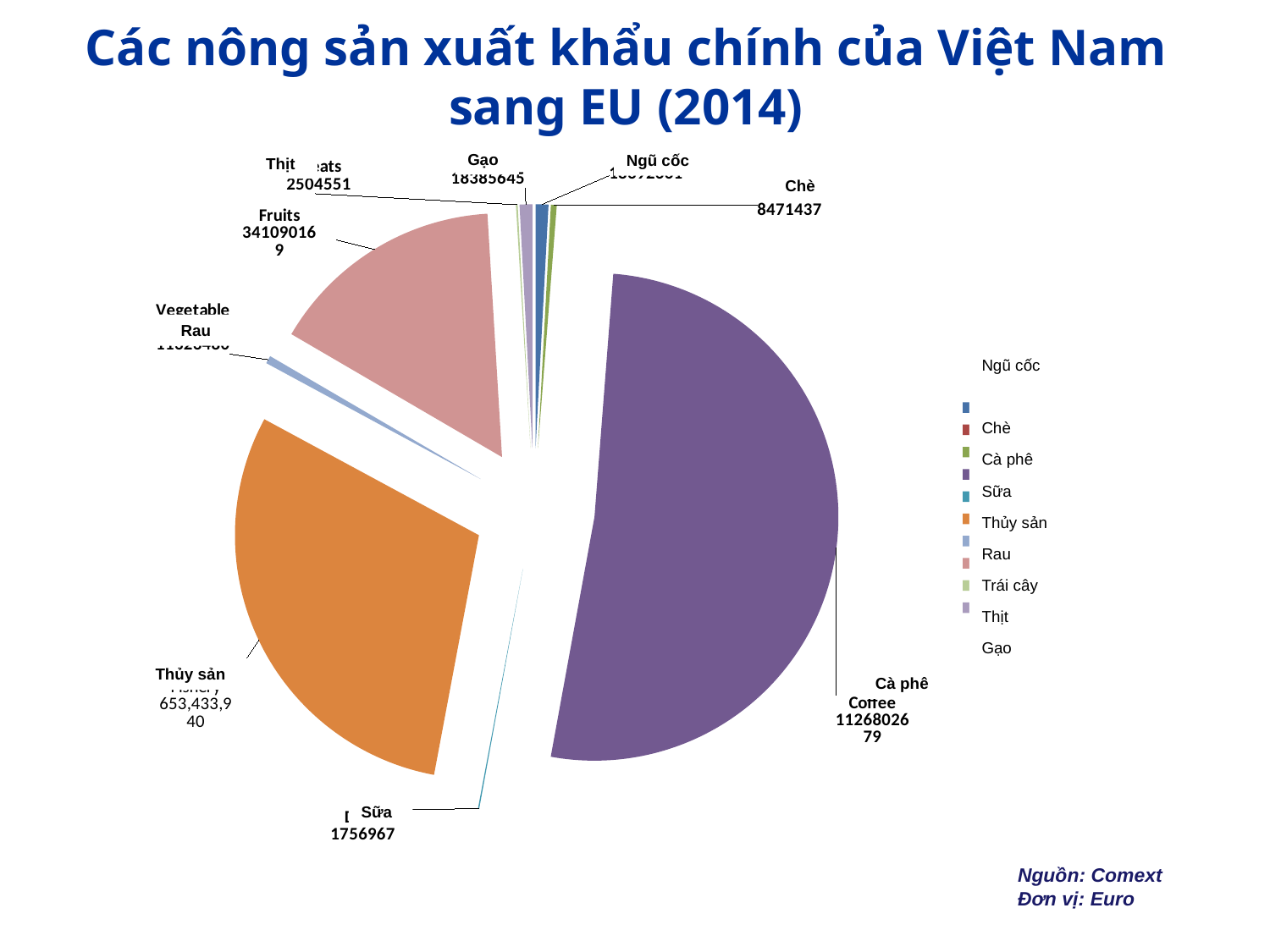
What unit are the values in, according to the note on the slide? Euro What is the difference between the values for Thịt and Sữa? 747584 What is the value shown for Cà phê (Coffee)? 1126802679 What is the value shown for Sữa? 1756967 What is the value shown for Thủy sản? 653,433,940 Which category has the largest slice of the pie? Cà phê What is the value shown for Thịt? 2504551 Which is larger, the value for Thủy sản or the value for Trái cây (Fruits)? Thủy sản How many categories does the legend of the pie chart list? 9 What is the value shown for Chè? 8471437 What kind of chart is shown on the slide? pie chart What is the value shown for Gạo? 18385645